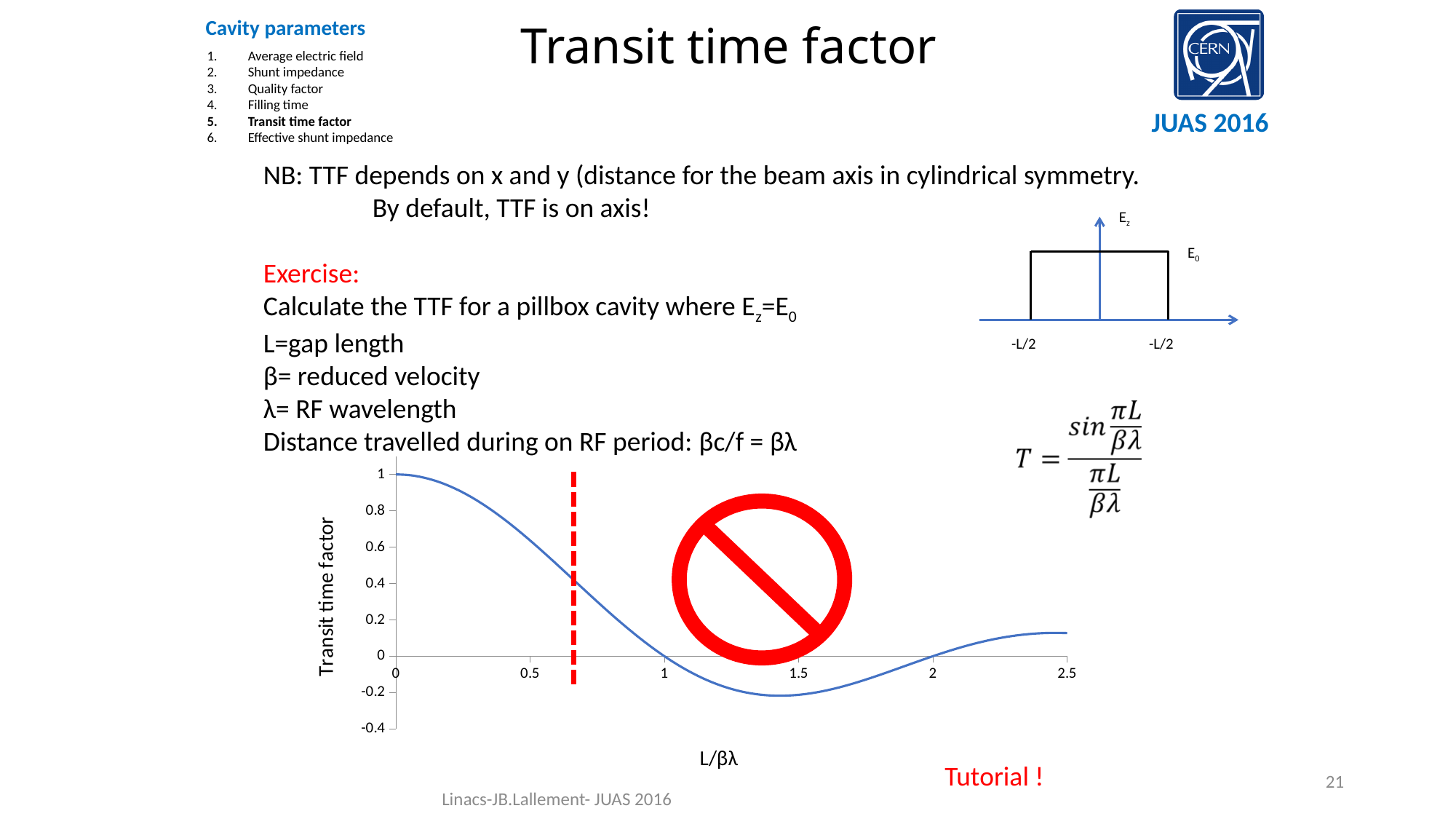
What kind of chart is shown on the slide? line chart At which value of L/βλ is the transit time factor highest? 0 Does the transit time factor rise or fall as L/βλ increases from 0 to 1? fall What is the transit time factor at L/βλ = 2? 0 What is the label of the y axis of the chart? Transit time factor What is the transit time factor at L/βλ = 0? 1 What is the label of the x axis of the chart? L/βλ Is the transit time factor at L/βλ = 0.5 greater or less than 0.4? greater Is the transit time factor at L/βλ = 1.5 greater or less than 0? less Which is larger, the transit time factor at L/βλ = 0.5 or at L/βλ = 2.5? L/βλ = 0.5 How many tick labels are shown on the x axis of the chart? 6 What is the transit time factor at L/βλ = 1? 0